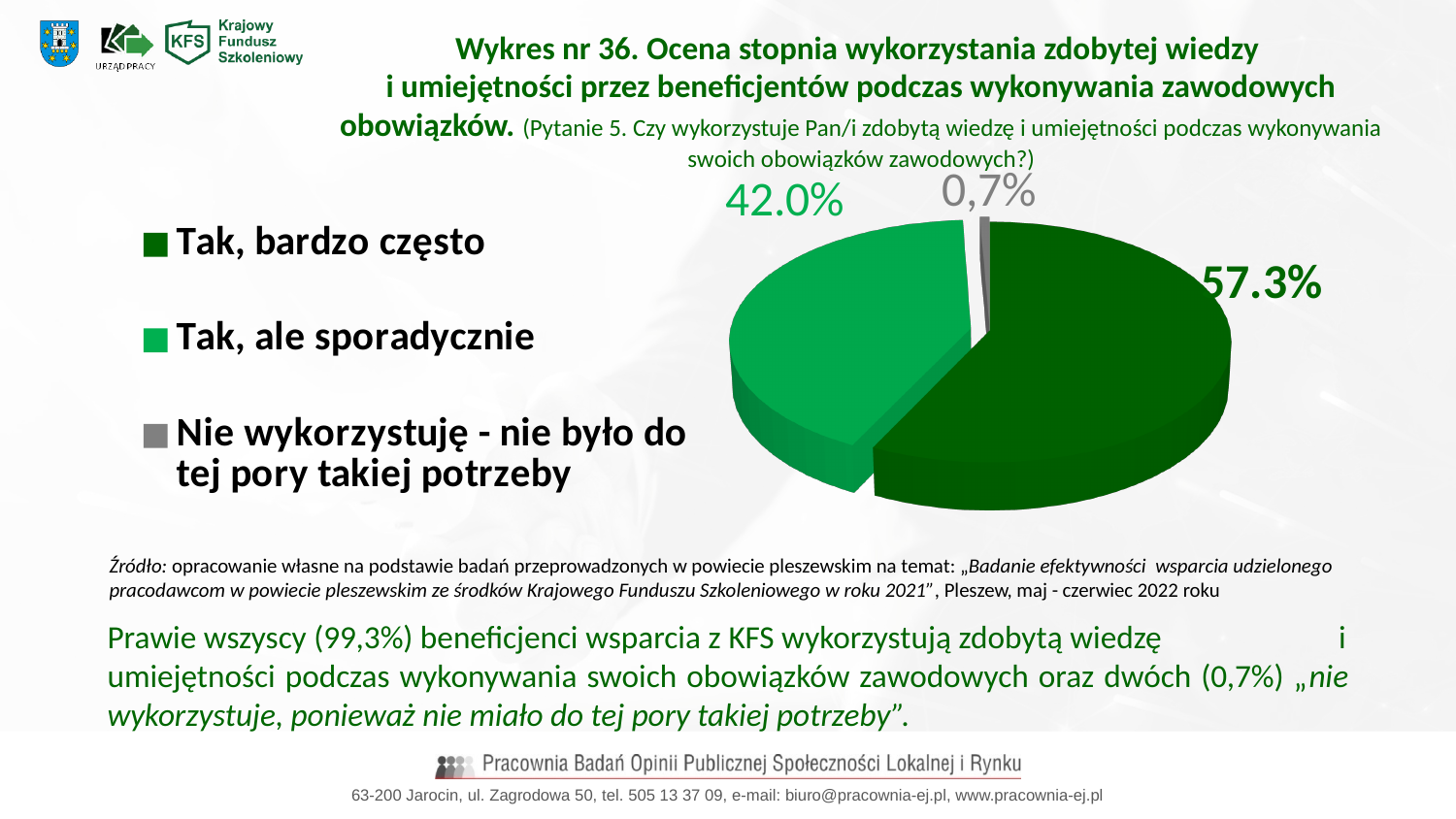
Which category has the largest slice of the pie? Tak, bardzo często What share of respondents answered "Tak, ale sporadycznie"? 42.0% What is the number of the chart given in its title? Wykres nr 36 What is the difference in percentage points between "Tak, bardzo często" (57.3%) and "Tak, ale sporadycznie" (42.0%)? 15.3 percentage points What colour is the slice for "Nie wykorzystuję - nie było do tej pory takiej potrzeby"? grey How many categories does the pie chart show? 3 Which category has the smallest slice of the pie? Nie wykorzystuję - nie było do tej pory takiej potrzeby Which is larger: the share for "Tak, bardzo często" or for "Tak, ale sporadycznie"? Tak, bardzo często What is the combined share of the two "Tak" answers (57.3% and 42.0%)? 99.3% What kind of chart is shown on the slide? pie chart What share of respondents answered "Nie wykorzystuję - nie było do tej pory takiej potrzeby"? 0,7% What share of respondents answered "Tak, bardzo często"? 57.3%